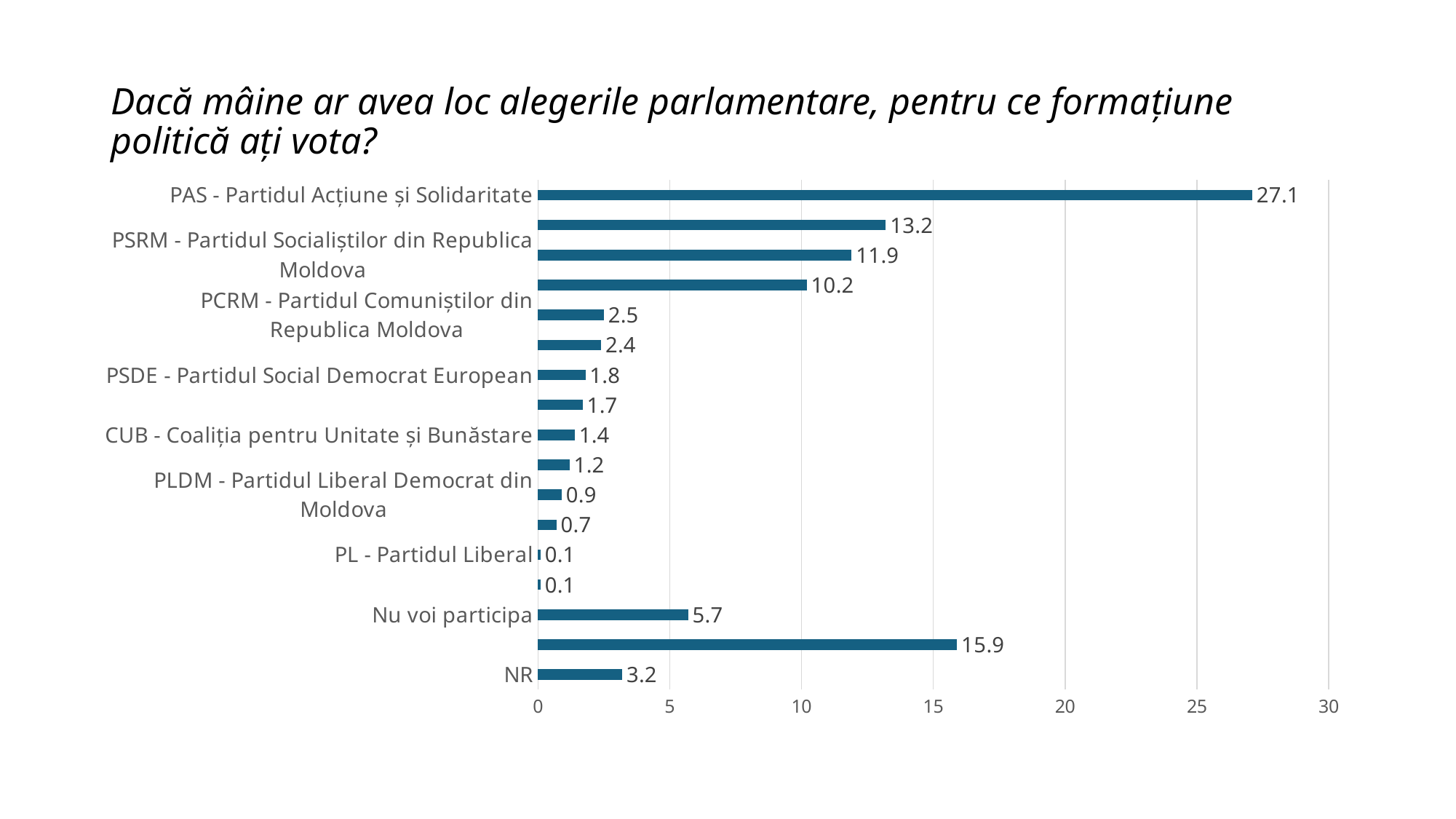
Which labelled category has the highest value? PAS - Partidul Acțiune și Solidaritate What is the value for Nu voi participa? 5.7 What is the value for PSDE - Partidul Social Democrat European? 1.8 What is the value for CUB - Coaliția pentru Unitate și Bunăstare? 1.4 What is the value for the bar labelled NR? 3.2 What is the largest value shown on the chart? 27.1 Which is larger, the value for Nu voi participa or the value for NR? Nu voi participa What is the value for PL - Partidul Liberal? 0.1 What is the value for PAS - Partidul Acțiune și Solidaritate? 27.1 Is the value for PAS - Partidul Acțiune și Solidaritate greater or less than 25? greater What kind of chart is shown on the slide? bar chart How many bars are plotted on the chart? 17